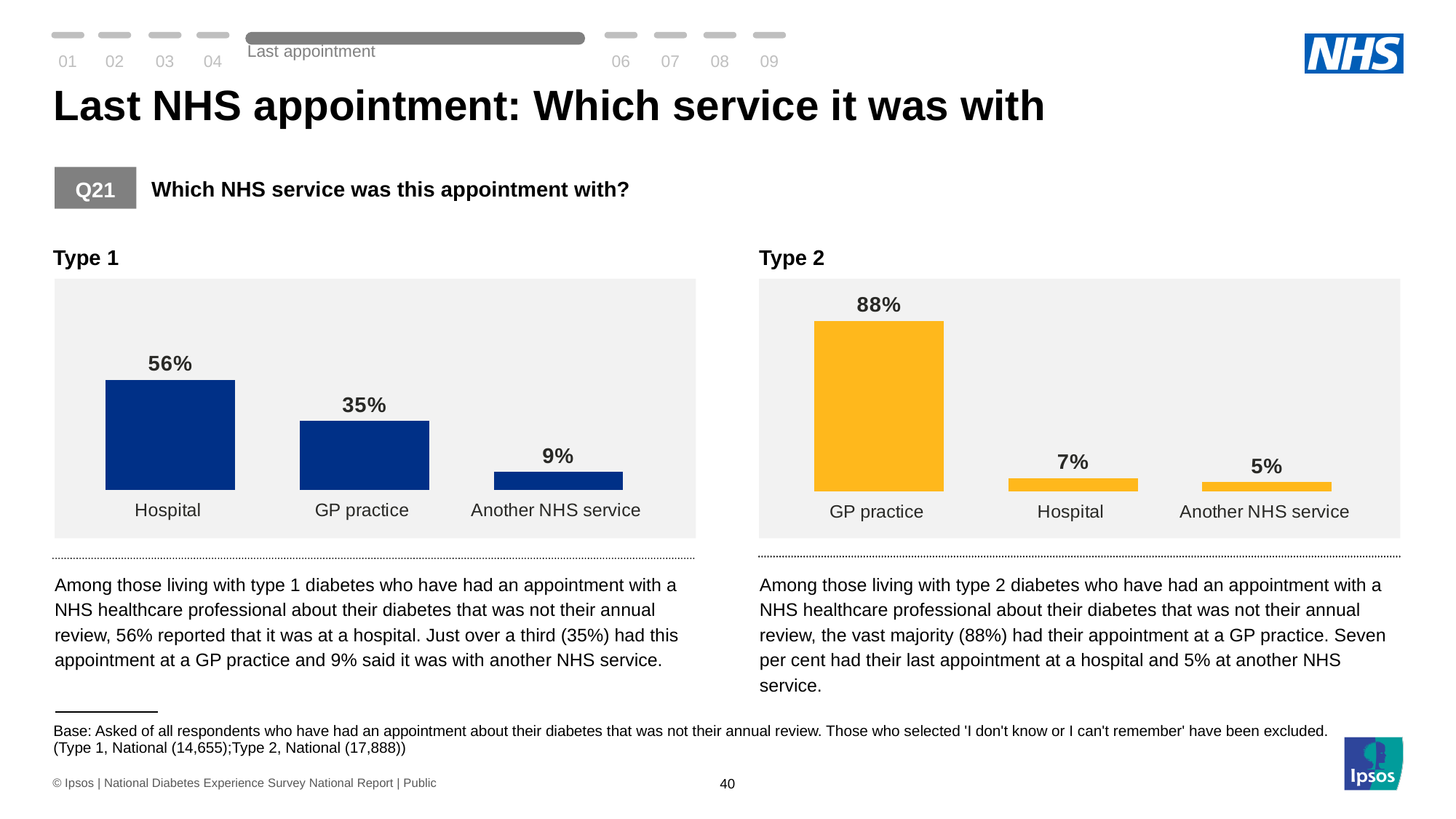
In the Type 2 chart, what percentage of respondents said their last appointment was at a GP practice? 88% How many categories are shown in the Type 2 chart? 3 What colour are the bars in the Type 2 chart? Yellow In the Type 2 chart, what is the value for Hospital? 7% In the Type 2 chart, what is the difference between the GP practice and Hospital values? 81 percentage points What kind of chart is the Type 1 chart? Bar chart In the Type 1 chart, what is the value for Another NHS service? 9% In the Type 1 chart, what is the difference between the Hospital and GP practice values? 21 percentage points In the Type 1 chart, which category has the highest value? Hospital Which is larger: the GP practice value in the Type 1 chart or the GP practice value in the Type 2 chart? Type 2 In the Type 2 chart, which category has the lowest value? Another NHS service In the Type 1 chart, what percentage of respondents said their last appointment was at a hospital? 56%